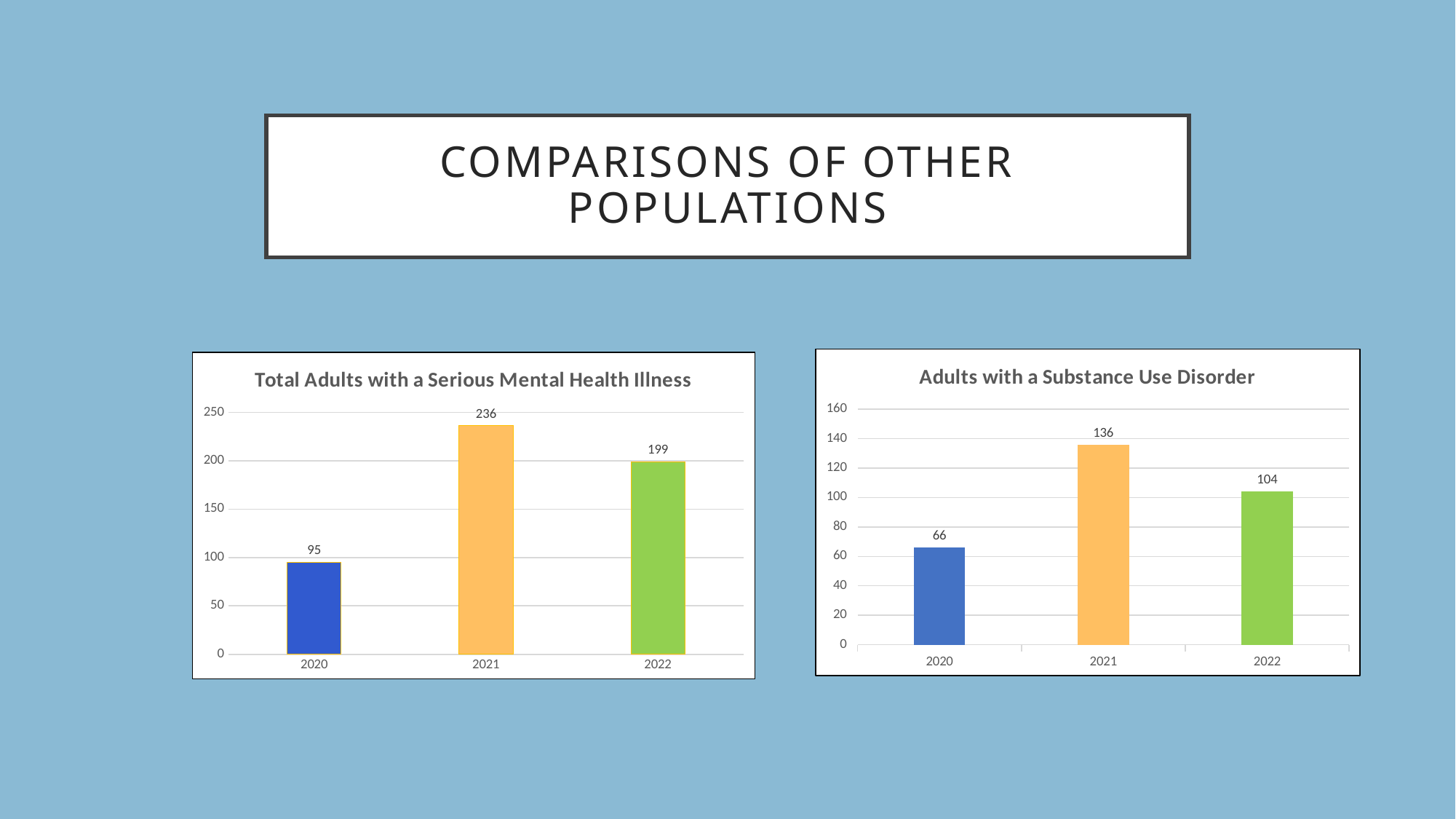
In the 'Total Adults with a Serious Mental Health Illness' chart, what is the difference between the 2021 and 2022 values? 37 In the 'Adults with a Substance Use Disorder' chart, what is the value for 2022? 104 In the 'Adults with a Substance Use Disorder' chart, which year has the lowest value? 2020 In the 'Total Adults with a Serious Mental Health Illness' chart, what is the value for 2020? 95 How many years are shown on the x axis of the 'Adults with a Substance Use Disorder' chart? 3 What kind of chart is the 'Total Adults with a Serious Mental Health Illness' chart? bar chart In the 'Total Adults with a Serious Mental Health Illness' chart, is the value for 2022 greater or less than 150? greater In the 'Total Adults with a Serious Mental Health Illness' chart, which year has the highest value? 2021 In the 'Adults with a Substance Use Disorder' chart, what is the difference between the 2021 and 2020 values? 70 What is the title of the chart on the right side of the slide? Adults with a Substance Use Disorder In the 'Adults with a Substance Use Disorder' chart, which is larger, the value for 2021 or the value for 2022? 2021 In the 'Total Adults with a Serious Mental Health Illness' chart, what is the value for 2021? 236